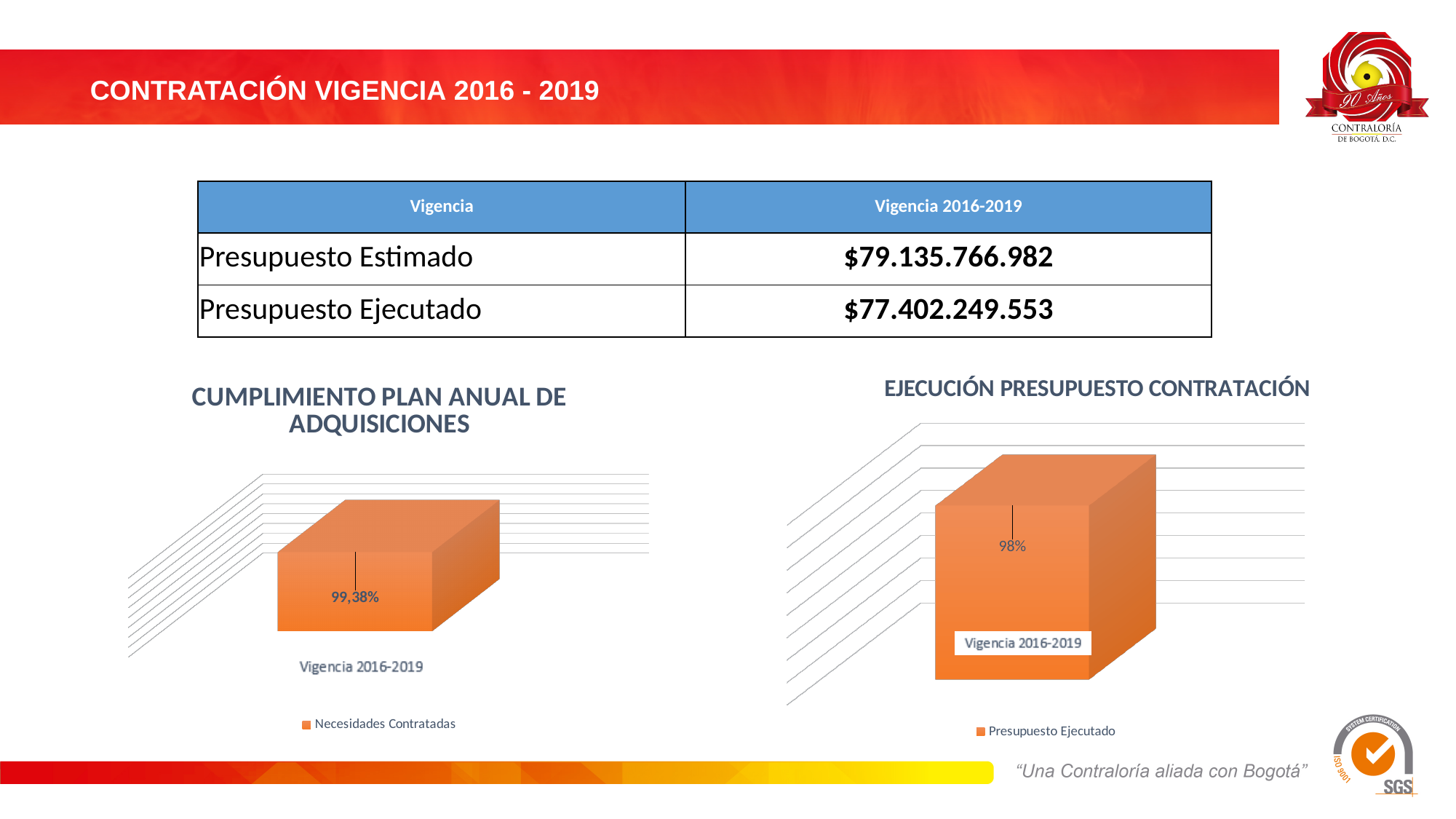
What kind of chart is the one titled 'EJECUCIÓN PRESUPUESTO CONTRATACIÓN'? Bar chart How many bars are plotted in the chart titled 'CUMPLIMIENTO PLAN ANUAL DE ADQUISICIONES'? 1 How many series does the legend list in the chart titled 'CUMPLIMIENTO PLAN ANUAL DE ADQUISICIONES'? 1 What is the name of the series in the legend of the chart titled 'CUMPLIMIENTO PLAN ANUAL DE ADQUISICIONES'? Necesidades Contratadas What kind of chart is the one titled 'CUMPLIMIENTO PLAN ANUAL DE ADQUISICIONES'? Bar chart Which is larger: the value in the 'CUMPLIMIENTO PLAN ANUAL DE ADQUISICIONES' chart or the value in the 'EJECUCIÓN PRESUPUESTO CONTRATACIÓN' chart? CUMPLIMIENTO PLAN ANUAL DE ADQUISICIONES How many series does the legend list in the chart titled 'EJECUCIÓN PRESUPUESTO CONTRATACIÓN'? 1 In the chart titled 'CUMPLIMIENTO PLAN ANUAL DE ADQUISICIONES', what is the value shown for Vigencia 2016-2019? 99,38% What is the name of the series in the legend of the chart titled 'EJECUCIÓN PRESUPUESTO CONTRATACIÓN'? Presupuesto Ejecutado How many bars are plotted in the chart titled 'EJECUCIÓN PRESUPUESTO CONTRATACIÓN'? 1 In the chart titled 'EJECUCIÓN PRESUPUESTO CONTRATACIÓN', what is the value shown for Vigencia 2016-2019? 98%